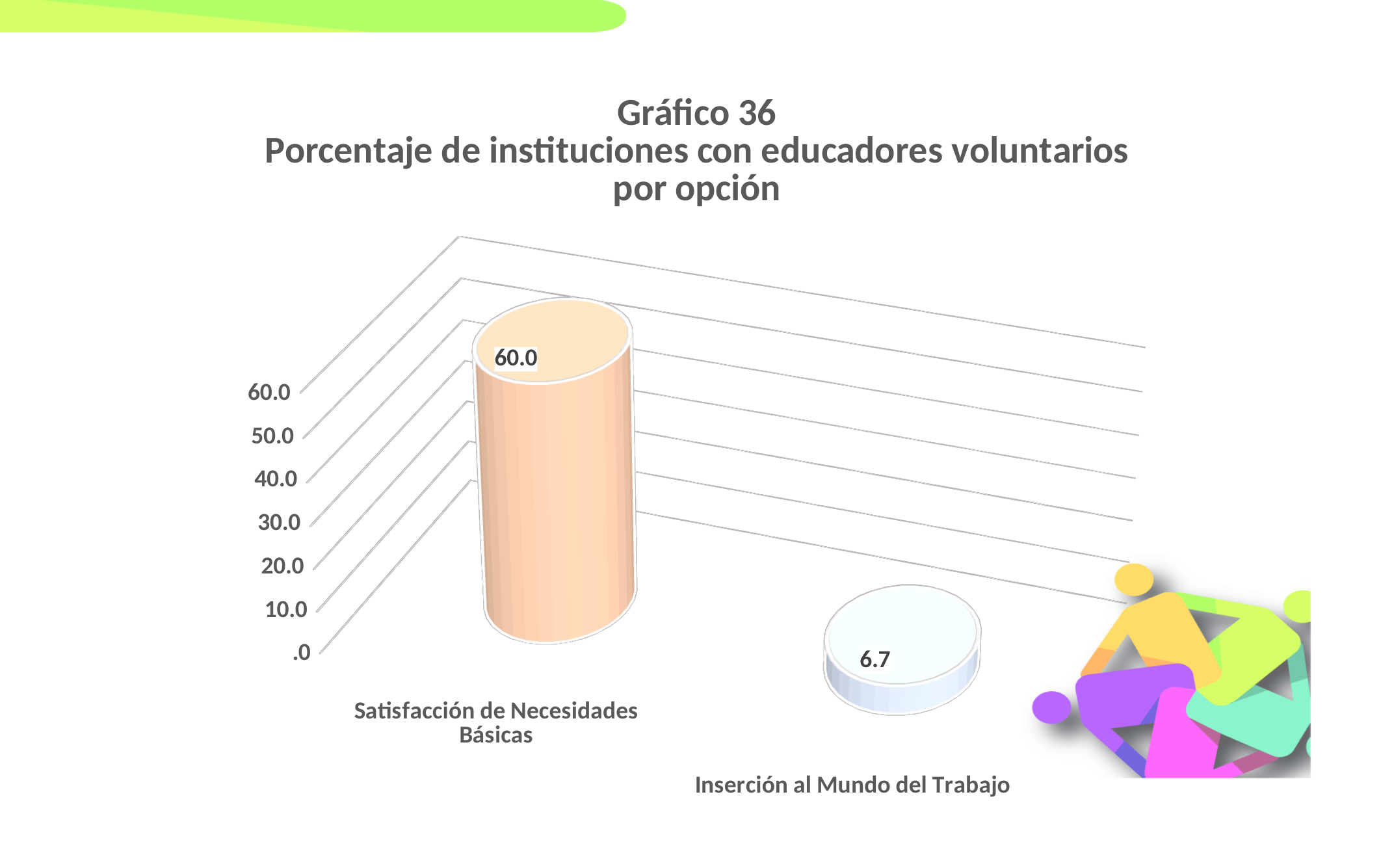
Is the value for Inserción al Mundo del Trabajo greater or less than 10.0? less What is the highest value shown on the vertical axis? 60.0 Is the value for Satisfacción de Necesidades Básicas greater or less than 50.0? greater What is the value for Satisfacción de Necesidades Básicas? 60.0 What is the number of the chart given in its title? Gráfico 36 How many categories are shown in the chart? 2 What is the difference between the values for Satisfacción de Necesidades Básicas and Inserción al Mundo del Trabajo? 53.3 Which is larger, the value for Satisfacción de Necesidades Básicas or the value for Inserción al Mundo del Trabajo? Satisfacción de Necesidades Básicas What kind of chart is shown on the slide? Bar chart Which category has the highest value? Satisfacción de Necesidades Básicas Which category has the lowest value? Inserción al Mundo del Trabajo What is the value for Inserción al Mundo del Trabajo? 6.7